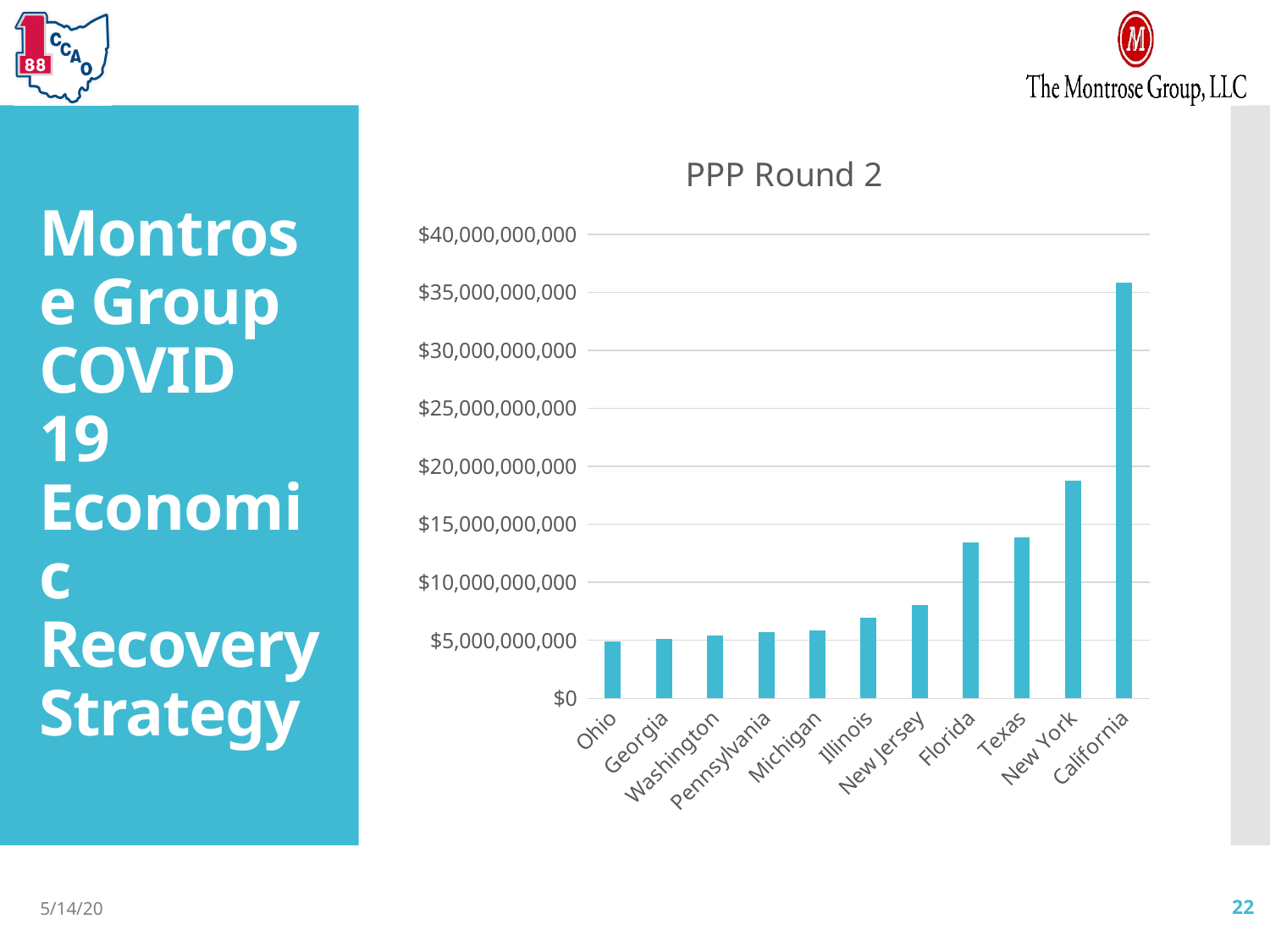
Which state has the highest value in the PPP Round 2 chart? California Is the value for Florida greater or less than $10,000,000,000? greater Which has a larger value, New York or Texas? New York Is the value for New Jersey greater or less than $10,000,000,000? less What is the title of the chart? PPP Round 2 Is the value for Texas greater or less than $15,000,000,000? less Do the values rise or fall moving from Ohio to California along the x axis? rise How many states are shown on the x axis of the chart? 11 What kind of chart is shown on the slide? bar chart Which has a larger value, Florida or California? California